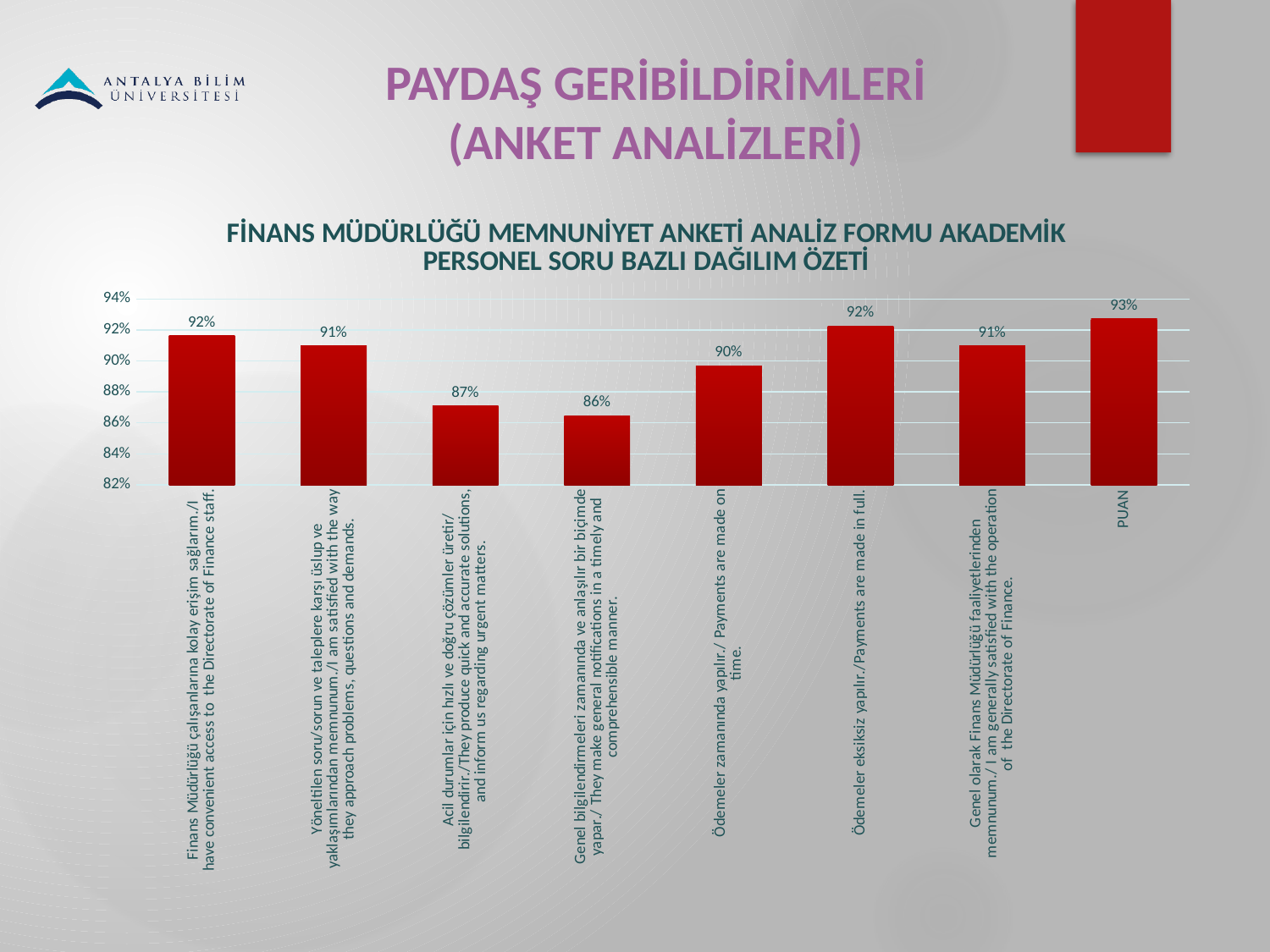
What is the value for the category about 'Acil durumlar için hızlı ve doğru çözümler üretir' (They produce quick and accurate solutions)? 87% Is the value for 'Genel olarak Finans Müdürlüğü faaliyetlerinden memnunum./ I am generally satisfied with the operation of the Directorate of Finance.' greater or less than 90%? greater How many bars are plotted in the chart? 8 What is the value for the category 'Ödemeler zamanında yapılır./ Payments are made on time.'? 90% Which is larger: the value for 'Payments are made on time' or the value for 'They make general notifications in a timely and comprehensible manner'? Payments are made on time What is the value for the category 'Ödemeler eksiksiz yapılır./Payments are made in full.'? 92% What is the title of the chart? FİNANS MÜDÜRLÜĞÜ MEMNUNİYET ANKETİ ANALİZ FORMU AKADEMİK PERSONEL SORU BAZLI DAĞILIM ÖZETİ Which category has the lowest value in the chart? Genel bilgilendirmeleri zamanında ve anlaşılır bir biçimde yapar./ They make general notifications in a timely and comprehensible manner. What type of chart is shown on the slide? bar chart Which category has the highest value in the chart? PUAN What is the value of the PUAN bar? 93% What is the difference between the PUAN value and the value for 'Payments are made on time'? 3%